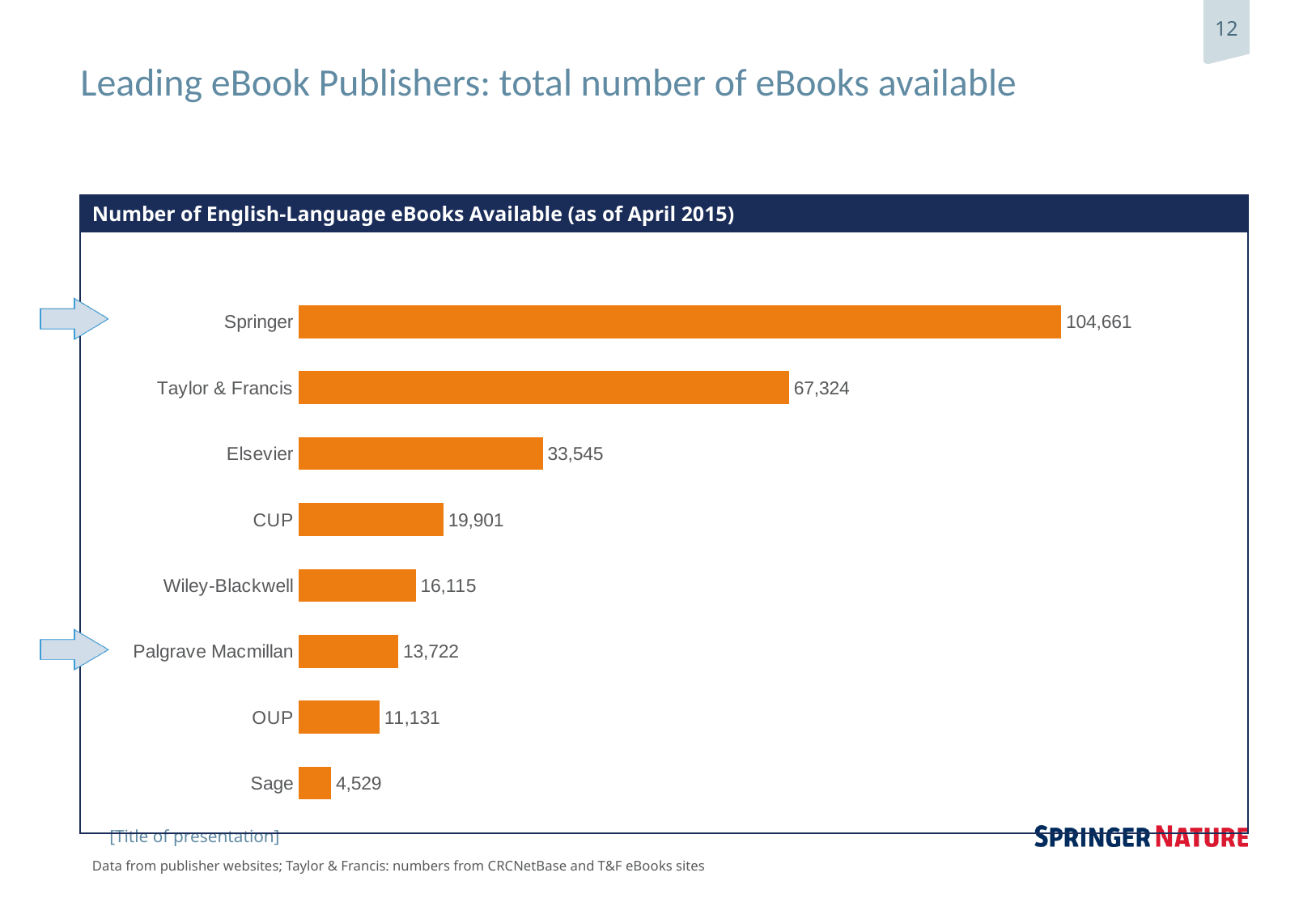
What is the number of eBooks available for Wiley-Blackwell? 16,115 How many publishers are shown in the chart? 8 What value is shown for Palgrave Macmillan? 13,722 What is the difference between the number of eBooks for Springer and Taylor & Francis? 37,337 What is the difference between the values for CUP and OUP? 8,770 Which publisher has the lowest number of eBooks available? Sage Which publisher has the highest number of eBooks available? Springer Which has more eBooks available, OUP or Wiley-Blackwell? Wiley-Blackwell How many English-language eBooks does Springer have available according to the chart? 104,661 What type of chart is used on this slide? Bar chart Which has more eBooks available, Elsevier or CUP? Elsevier What is the title of the chart? Number of English-Language eBooks Available (as of April 2015)